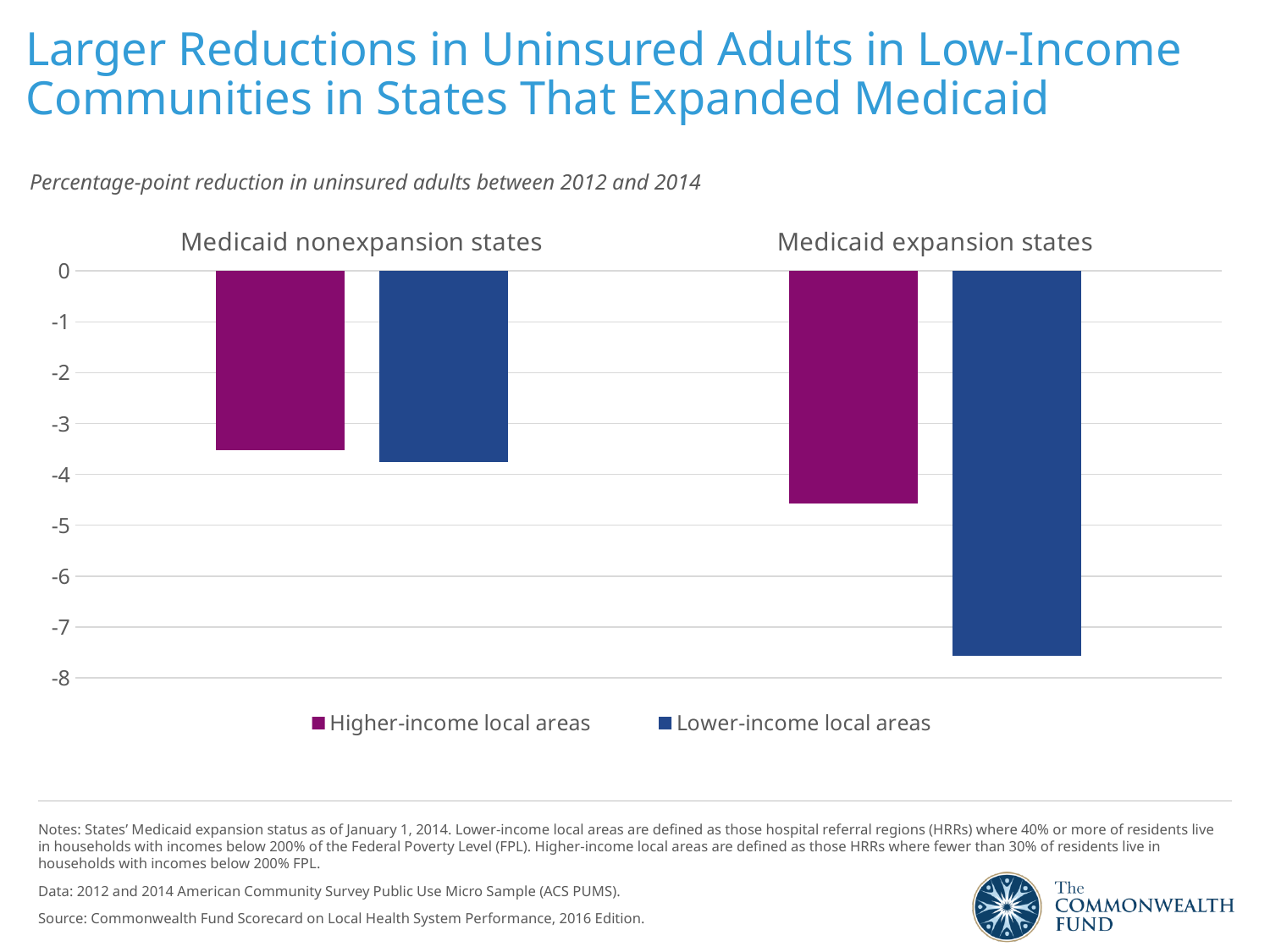
Is the value for Lower-income local areas in Medicaid nonexpansion states greater or less than -3? less Which bar shows the largest percentage-point reduction in uninsured adults? Lower-income local areas in Medicaid expansion states How many state groups are shown on the x axis? 2 Which shows a larger reduction in uninsured adults: Lower-income local areas in Medicaid expansion states or Lower-income local areas in Medicaid nonexpansion states? Lower-income local areas in Medicaid expansion states What kind of chart is shown on the slide? Bar chart What does the chart subtitle say is being measured? Percentage-point reduction in uninsured adults between 2012 and 2014 How many bars are plotted in the chart? 4 How many series does the legend list? 2 Is the value for Higher-income local areas in Medicaid expansion states greater or less than -4? less Is the value for Higher-income local areas in Medicaid nonexpansion states greater or less than -4? greater What colour represents Lower-income local areas in the chart? Blue